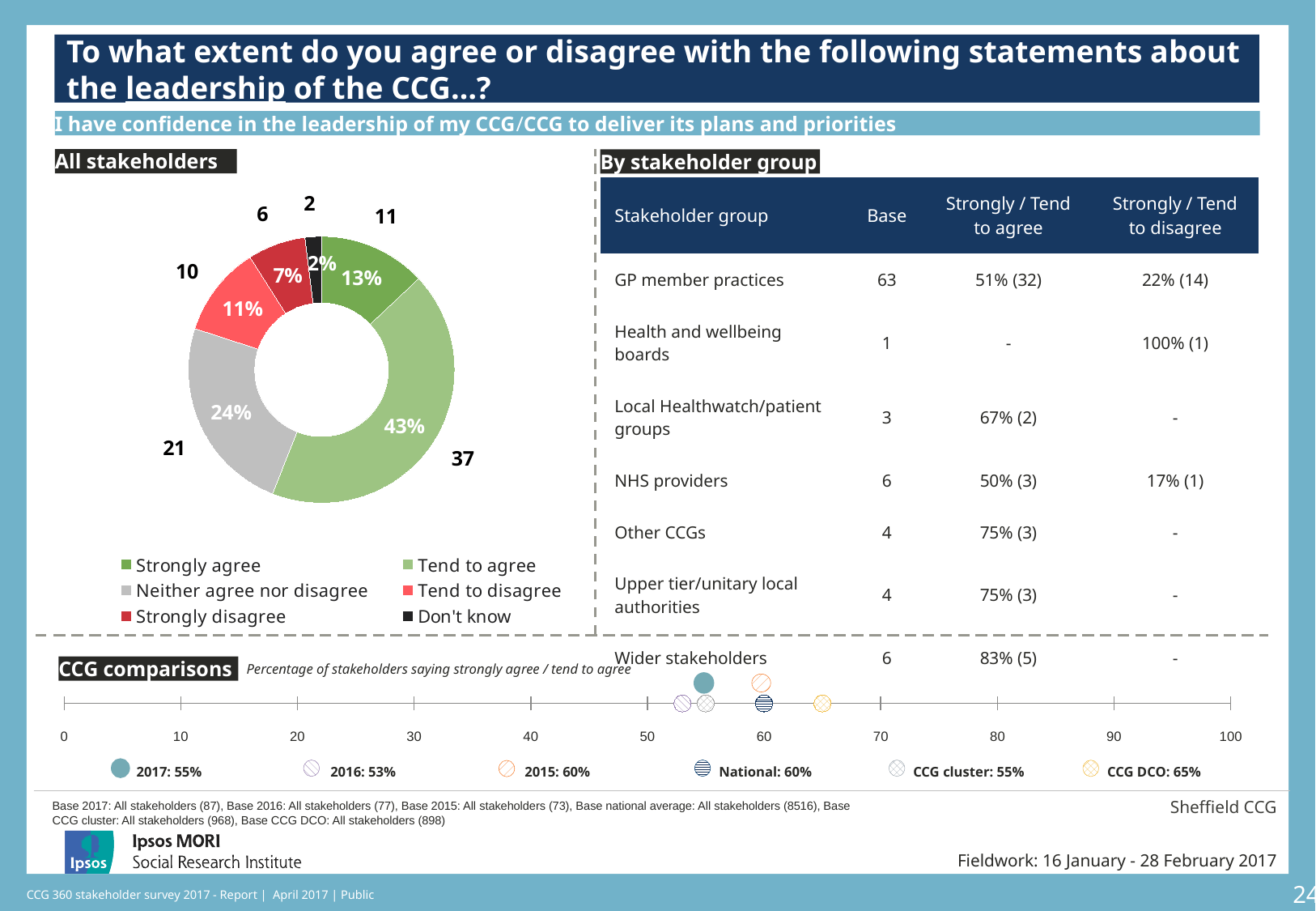
In the 'All stakeholders' donut chart, which response category has the largest share? Tend to agree In the 'CCG comparisons' chart, what is the difference in percentage points between the 2015 value and the 2016 value? 7 In the 'All stakeholders' donut chart, which is larger: the share for 'Tend to disagree' or the share for 'Strongly disagree'? Tend to disagree In the 'All stakeholders' donut chart, how many stakeholders said 'Strongly agree'? 11 In the 'All stakeholders' donut chart, which response category has the smallest share? Don't know In the 'CCG comparisons' chart, what percentage of stakeholders said strongly agree / tend to agree in 2017? 55% What type of chart is used for the 'All stakeholders' section? Donut chart In the 'All stakeholders' donut chart, what percentage of stakeholders said 'Tend to agree'? 43% In the 'All stakeholders' donut chart, what percentage of stakeholders said 'Neither agree nor disagree'? 24% How many response categories does the legend of the 'All stakeholders' donut chart list? 6 In the 'CCG comparisons' chart, which comparison point has the highest percentage? CCG DCO: 65% In the 'All stakeholders' donut chart, what is the difference in percentage points between 'Tend to agree' and 'Strongly agree'? 30